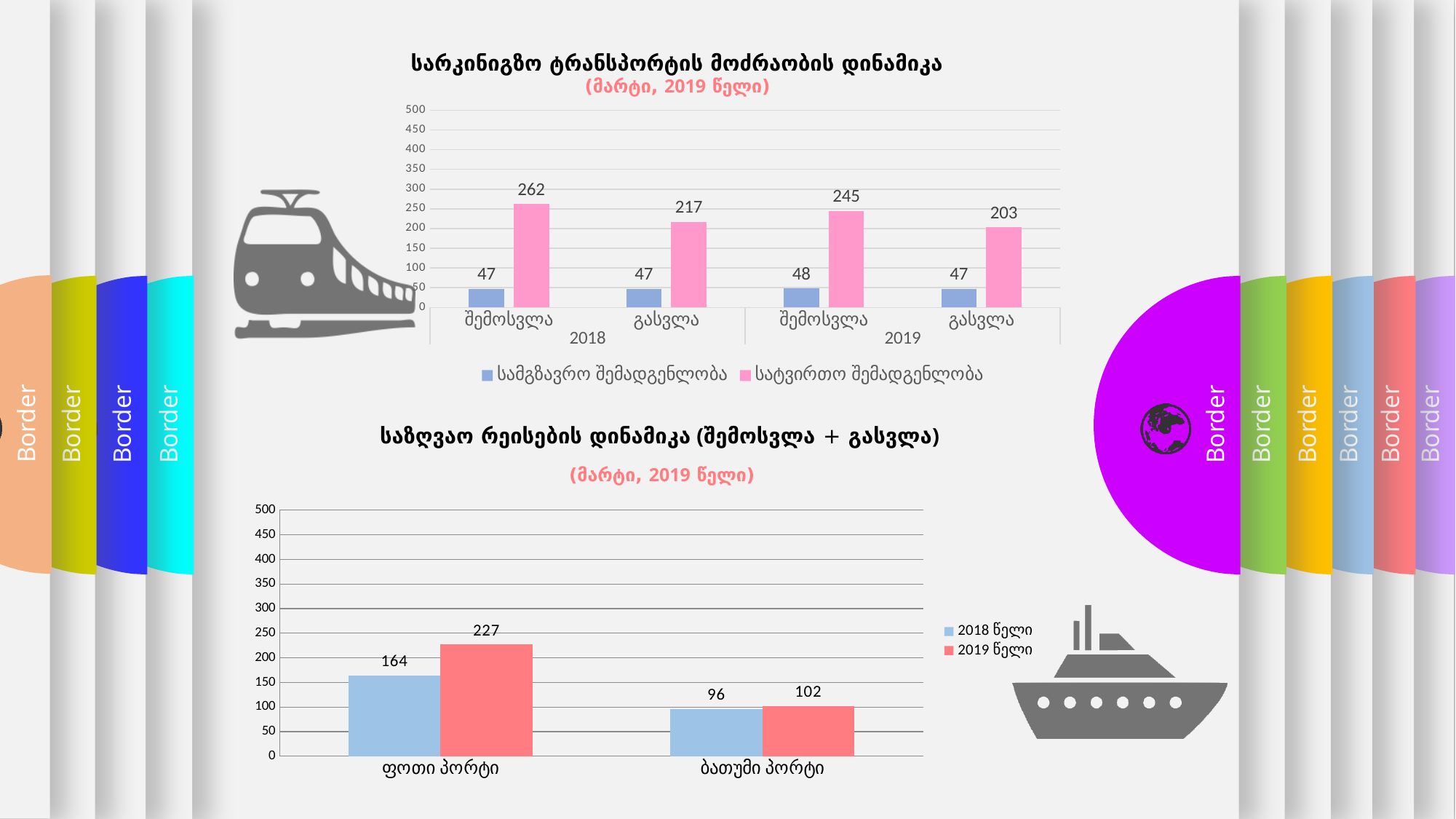
In the top chart (სარკინიგზო ტრანსპორტის მოძრაობის დინამიკა), what is the difference between the სატვირთო შემადგენლობა values for შემოსვლა 2018 and შემოსვლა 2019? 17 In the bottom chart (საზღვაო რეისების დინამიკა), how many port categories are shown on the x axis? 2 In the top chart (სარკინიგზო ტრანსპორტის მოძრაობის დინამიკა), which category has the lowest სატვირთო შემადგენლობა value? გასვლა 2019 In the top chart (სარკინიგზო ტრანსპორტის მოძრაობის დინამიკა), what is the value of სატვირთო შემადგენლობა for შემოსვლა in 2018? 262 In the top chart (სარკინიგზო ტრანსპორტის მოძრაობის დინამიკა), what is the value of სამგზავრო შემადგენლობა for შემოსვლა in 2019? 48 In the top chart (სარკინიგზო ტრანსპორტის მოძრაობის დინამიკა), which category has the highest სატვირთო შემადგენლობა value? შემოსვლა 2018 In the top chart (სარკინიგზო ტრანსპორტის მოძრაობის დინამიკა), what kind of chart is shown? bar chart In the bottom chart (საზღვაო რეისების დინამიკა), what is the difference between the 2019 წელი and 2018 წელი values for ფოთი პორტი? 63 In the top chart (სარკინიგზო ტრანსპორტის მოძრაობის დინამიკა), how many series does the legend list? 2 In the bottom chart (საზღვაო რეისების დინამიკა), which is larger: the 2018 წელი value for ფოთი პორტი or the 2019 წელი value for ბათუმი პორტი? 2018 წელი value for ფოთი პორტი In the bottom chart (საზღვაო რეისების დინამიკა), what is the value for ბათუმი პორტი in 2018 წელი? 96 In the bottom chart (საზღვაო რეისების დინამიკა), what is the value for ფოთი პორტი in 2019 წელი? 227